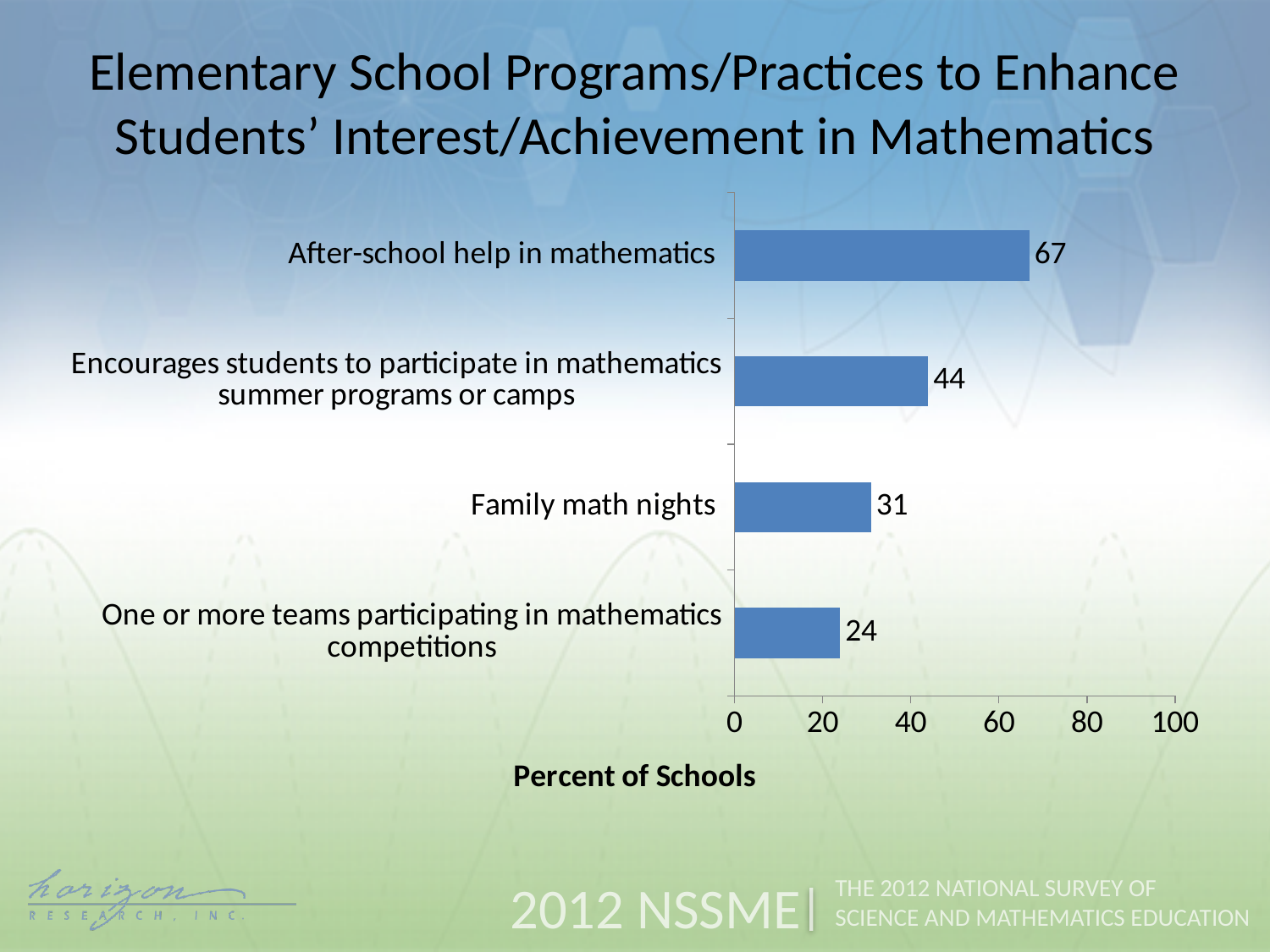
What kind of chart is shown on the slide? Bar chart What is the difference between the values for 'After-school help in mathematics' and 'Family math nights'? 36 What is the value for 'Encourages students to participate in mathematics summer programs or camps'? 44 Which is larger: the value for 'Family math nights' or for 'One or more teams participating in mathematics competitions'? Family math nights Which program/practice has the highest percent of schools? After-school help in mathematics What percent of schools have one or more teams participating in mathematics competitions? 24 Is the value for 'Encourages students to participate in mathematics summer programs or camps' greater or less than 40? greater What percent of schools offer after-school help in mathematics? 67 How many programs/practices are shown in the chart? 4 Which program/practice has the lowest percent of schools? One or more teams participating in mathematics competitions What is the label of the horizontal axis? Percent of Schools What is the value for 'Family math nights'? 31